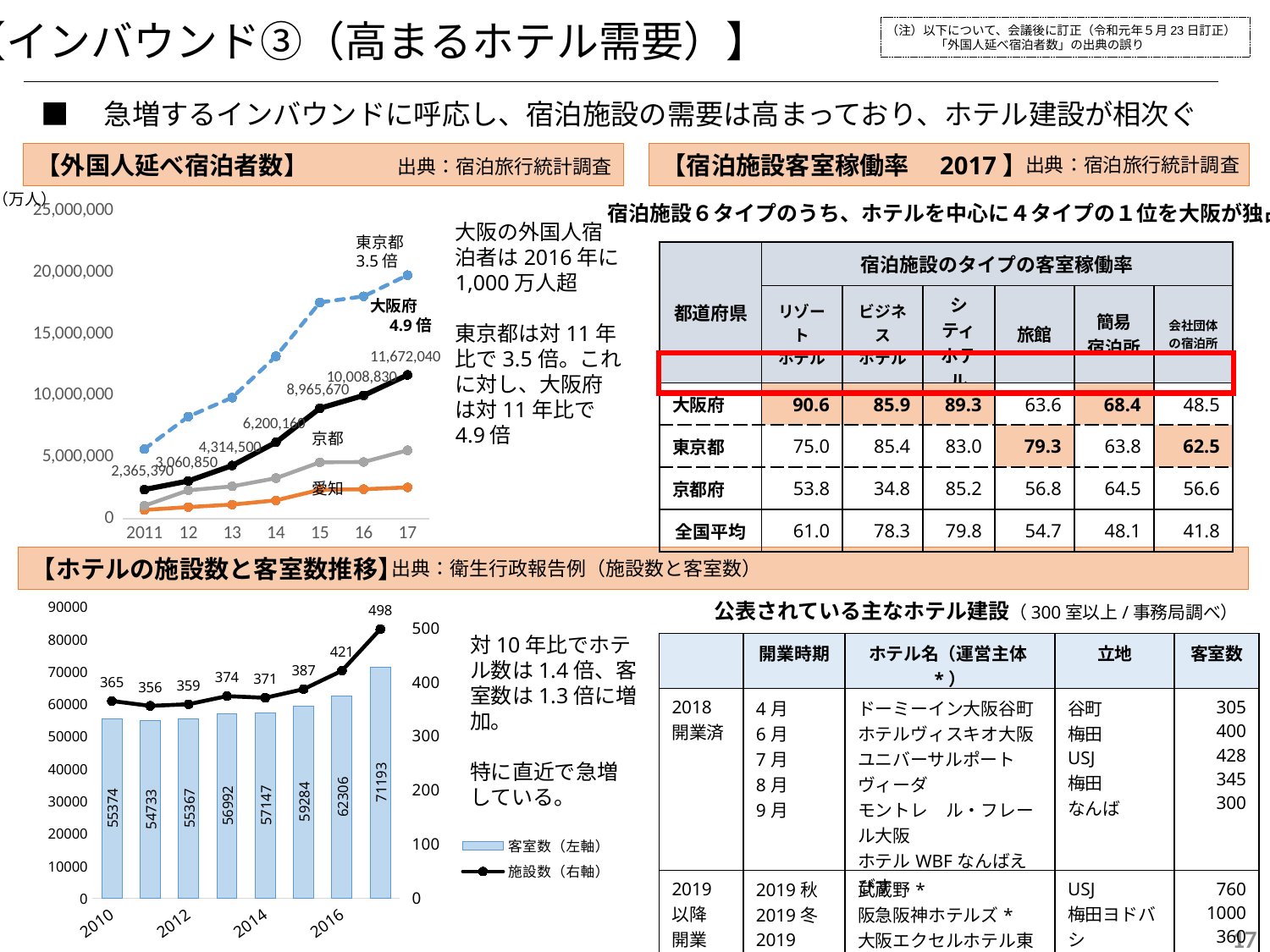
In the 【ホテルの施設数と客室数推移】 chart, what is the 施設数 value for 2016? 421 In the 【外国人延べ宿泊者数】 chart, which prefecture has the highest value in 2017? 東京都 In the 【ホテルの施設数と客室数推移】 chart, what is the difference between the 施設数 values for 2017 and 2016? 77 In the 【外国人延べ宿泊者数】 chart, what is the difference between the 大阪府 values for 2016 and 2015? 1,043,160 In the 【外国人延べ宿泊者数】 chart, how many years are plotted on the x axis? 7 In the 【外国人延べ宿泊者数】 chart, what is the value for 大阪府 in 2017? 11,672,040 In the 【外国人延べ宿泊者数】 chart, does the 大阪府 series rise or fall from 2011 to 2017? rise In the 【ホテルの施設数と客室数推移】 chart, which year has the lowest 客室数? 2011 In the 【外国人延べ宿泊者数】 chart, what is the value for 大阪府 in 2011? 2,365,390 In the 【外国人延べ宿泊者数】 chart, is the value for 東京都 in 2017 greater or less than 15,000,000? greater In the 【ホテルの施設数と客室数推移】 chart, what is the 客室数 value for 2017? 71193 In the 【ホテルの施設数と客室数推移】 chart, how many series does the legend list? 2